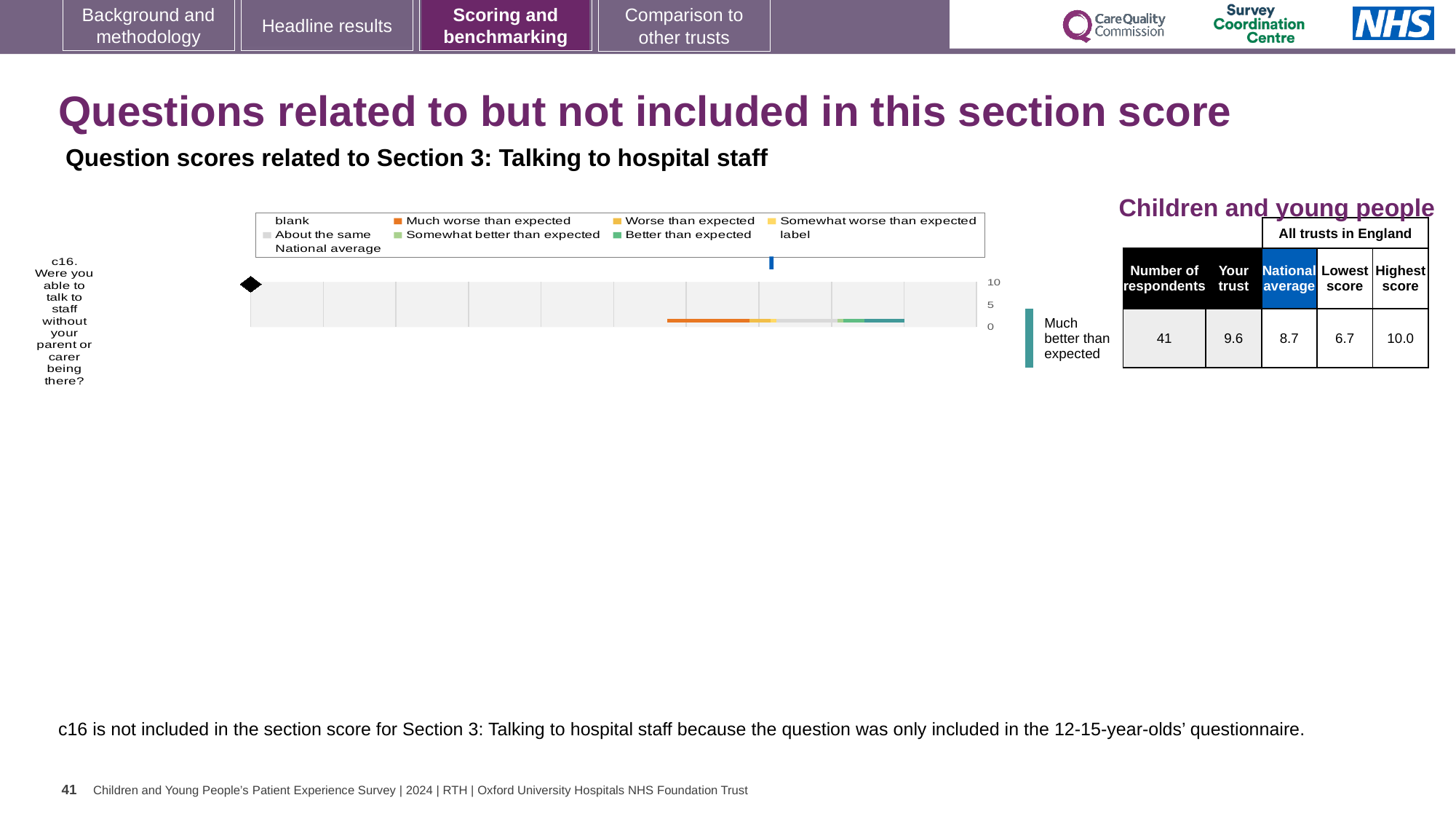
What is the trust's score for question c16? 9.6 What kind of chart is used to show the benchmarking result for question c16? bar chart Is the trust's score for c16 higher or lower than the national average? higher How many respondents answered question c16? 41 What benchmarking category is the trust's c16 result placed in? Much better than expected What is the highest value shown on the chart's score axis? 10 How many questions are plotted on the chart? 1 What is the highest score among all trusts in England for question c16? 10.0 What is the national average score for question c16? 8.7 What is the lowest score among all trusts in England for question c16? 6.7 Which question is plotted on the chart? c16. Were you able to talk to staff without your parent or carer being there? What is the difference between the trust's score and the national average for c16? 0.9